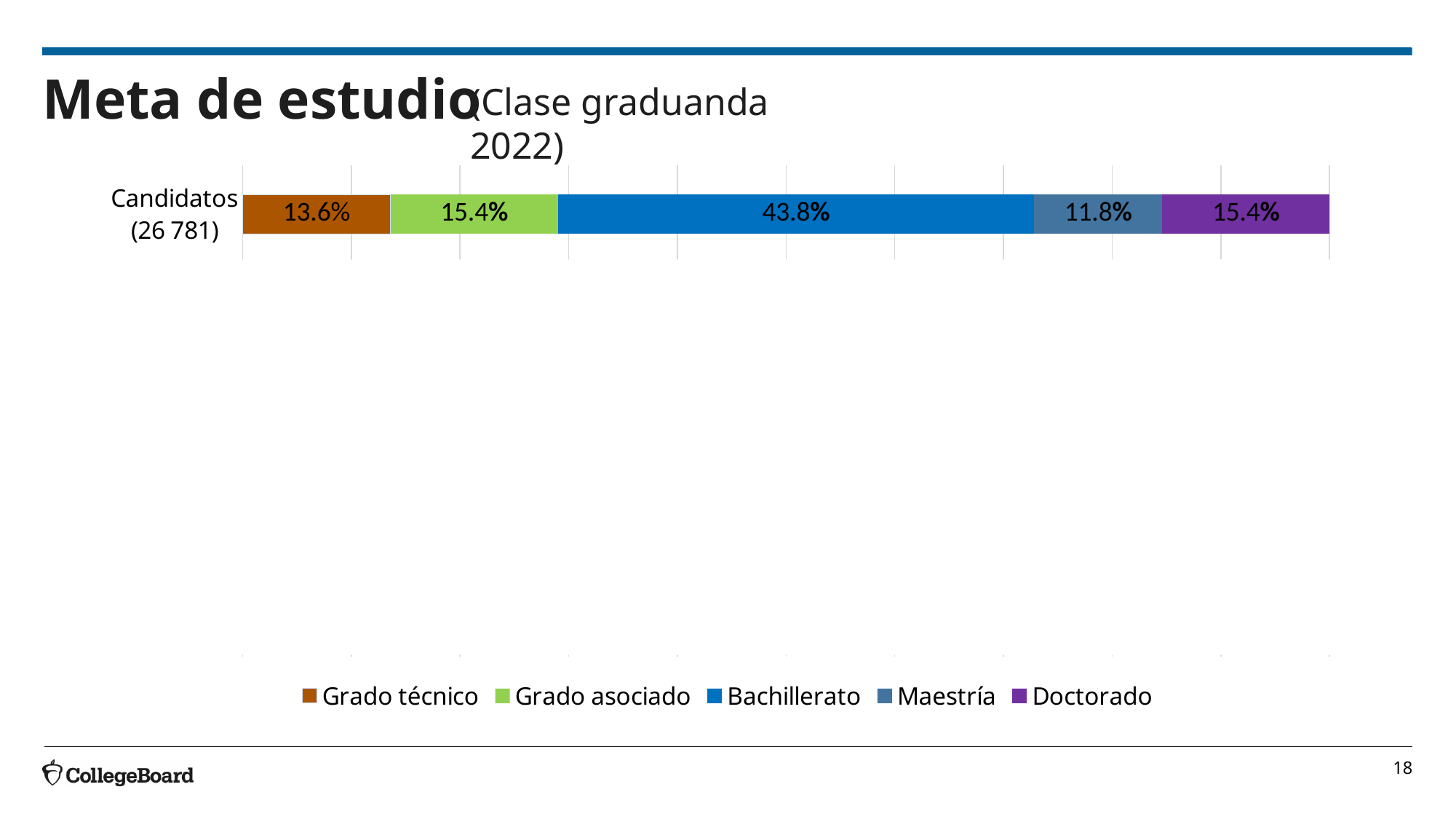
Which study goal has the smallest share of candidates? Maestría What percentage of candidates have Bachillerato as their study goal? 43.8% What is the difference in percentage points between Doctorado and Maestría? 3.6 What is the value shown for Grado técnico? 13.6% How many candidates are indicated in the category label of the bar? 26 781 What kind of chart is shown on the slide? Stacked bar chart Which study goal has the largest share of candidates? Bachillerato How many series does the legend list? 5 What is the difference in percentage points between Bachillerato and Grado técnico? 30.2 Which is larger, the share for Grado técnico or the share for Maestría? Grado técnico What is the value shown for Doctorado? 15.4% What is the value shown for Maestría? 11.8%